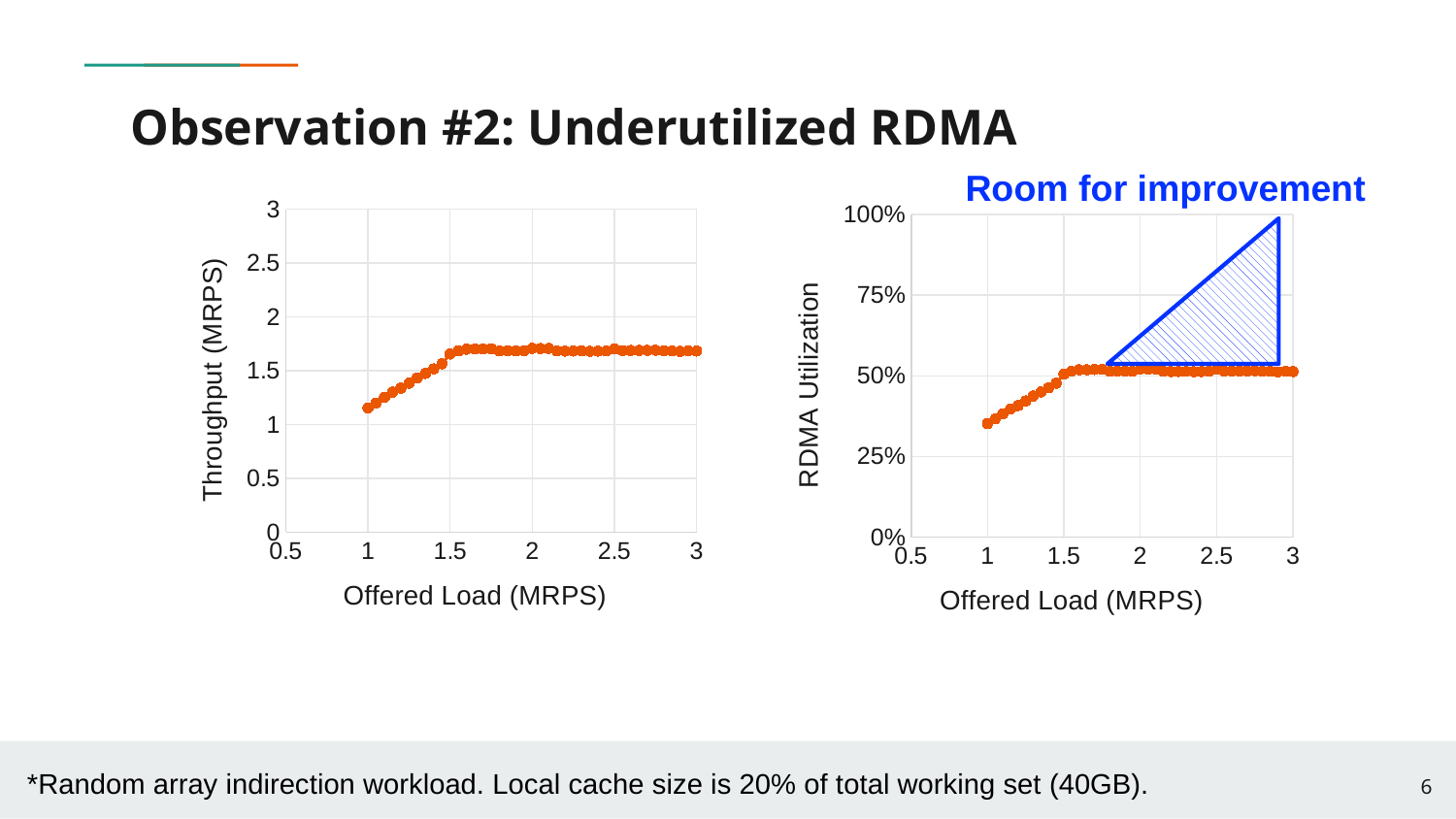
In the left chart (Throughput), does throughput keep rising or stay flat as offered load increases from 2 to 3 MRPS? stay flat In the left chart (Throughput), does throughput rise or fall as offered load increases from 1 to 1.5 MRPS? rise In the right chart (RDMA Utilization), is the utilization at an offered load of 3 MRPS greater or less than 75%? less In the left chart (Throughput), is the throughput at an offered load of 1 MRPS greater or less than 1? greater In the right chart (RDMA Utilization), does the plotted utilization ever exceed 75%? No In the right chart (RDMA Utilization), does utilization rise or fall as offered load increases from 1 to 1.5 MRPS? rise What is the y-axis label of the right chart? RDMA Utilization What is the x-axis label of the left chart? Offered Load (MRPS)